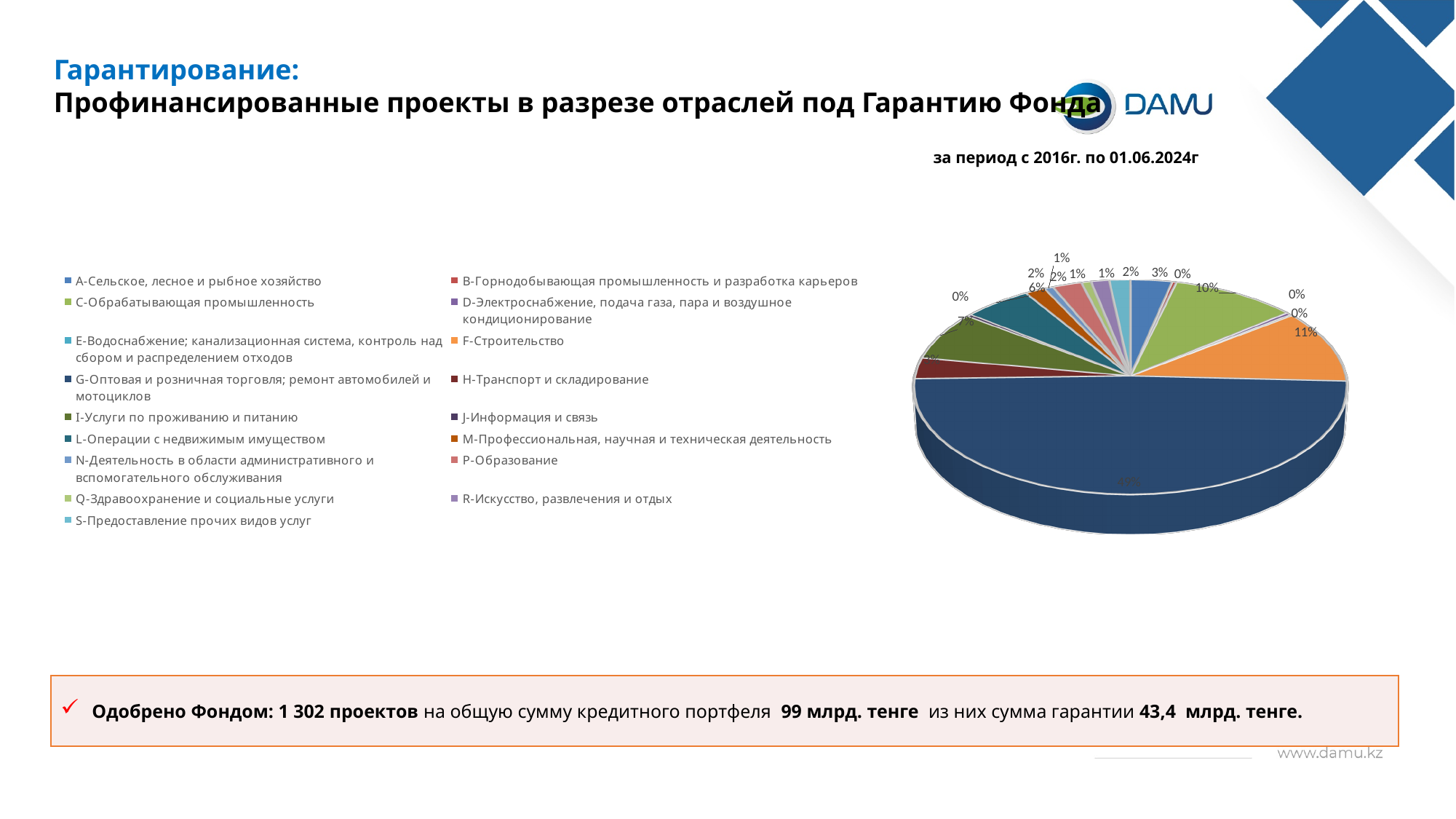
What colour is the slice for G-Оптовая и розничная торговля; ремонт автомобилей и мотоциклов? Dark blue What share of the pie does C-Обрабатывающая промышленность have? 10% How many industry categories does the legend list? 17 What kind of chart is shown on the slide? Pie chart How many projects were approved by the Fund, according to the text box at the bottom of the slide? 1 302 What period does the chart cover, according to the slide? с 2016г. по 01.06.2024г What is the difference between the shares of F-Строительство and C-Обрабатывающая промышленность? 1% Which industry has the largest share of the pie? G-Оптовая и розничная торговля; ремонт автомобилей и мотоциклов Which has a larger share, F-Строительство or C-Обрабатывающая промышленность? F-Строительство What share of the pie does F-Строительство have? 11%